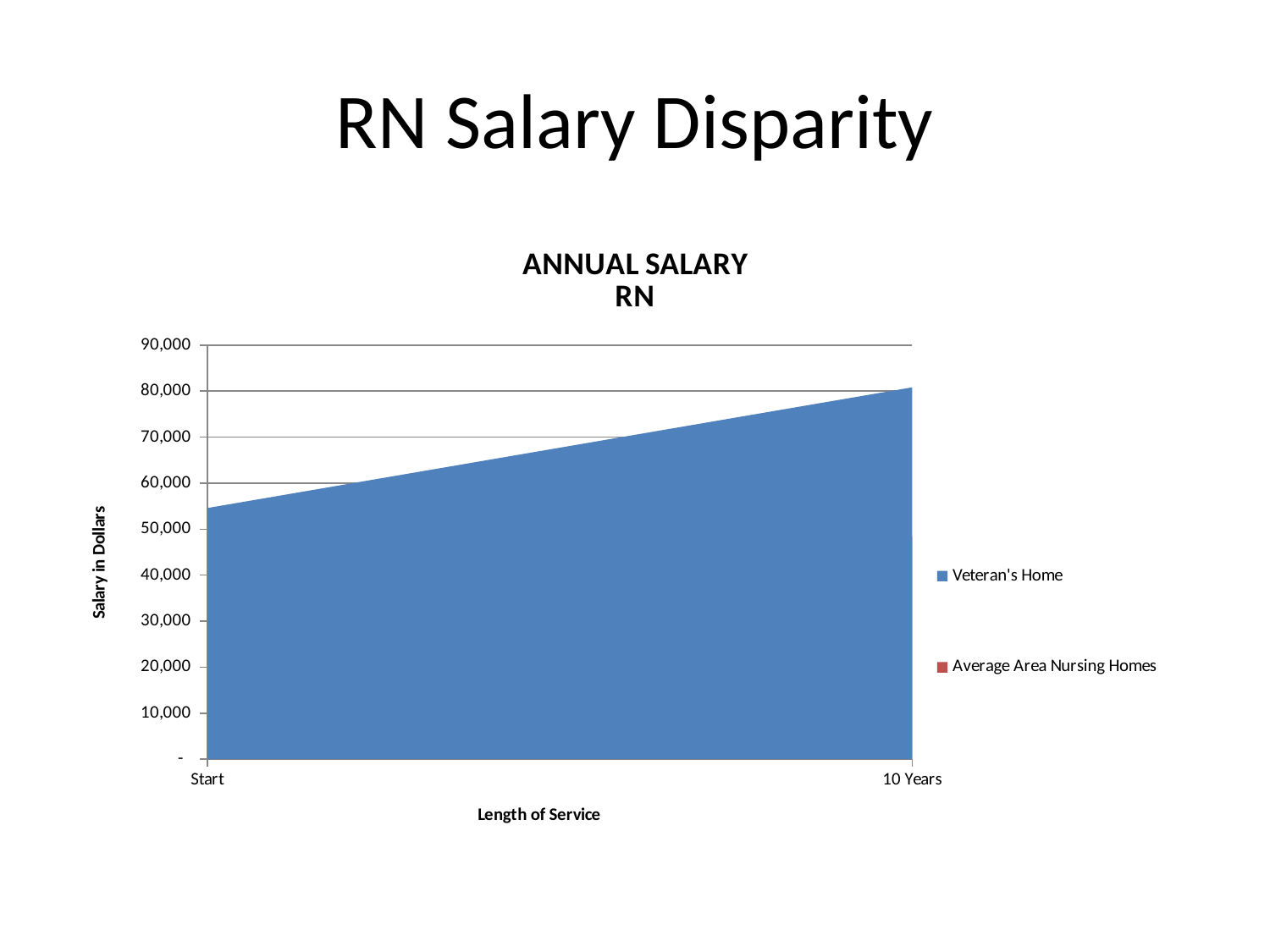
Is the Veteran's Home value at Start greater or less than 60,000? less Is the Veteran's Home value at Start greater or less than 50,000? greater Is the Veteran's Home value at 10 Years greater or less than 90,000? less How many series does the legend list? 2 Which category has the higher Veteran's Home value, Start or 10 Years? 10 Years How many categories are shown on the x axis? 2 Does the Veteran's Home salary rise or fall from Start to 10 Years? Rise What is the label of the y axis? Salary in Dollars What kind of chart is shown on the slide? Area chart What is the title of the chart? ANNUAL SALARY RN